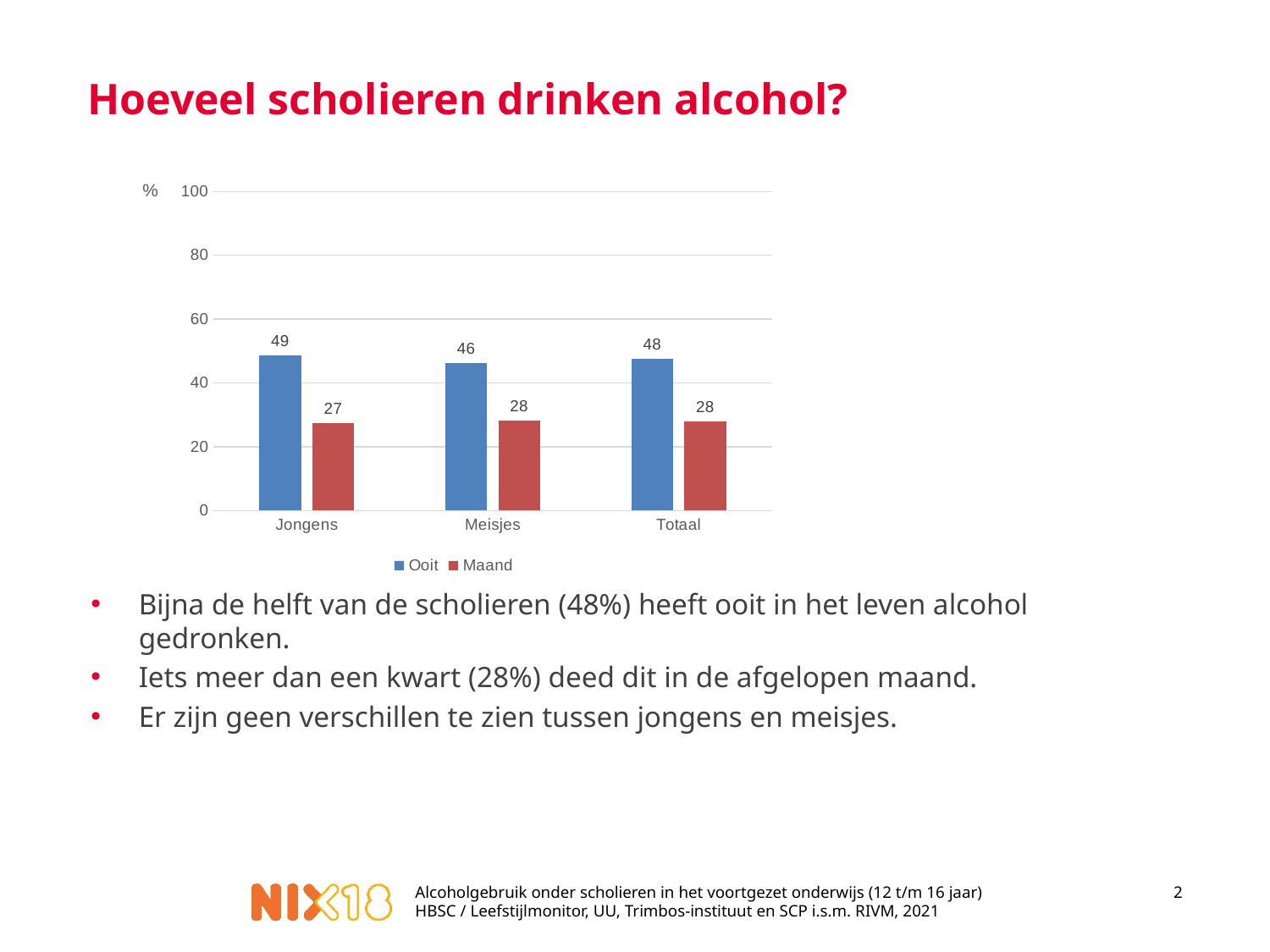
What is the difference between the Ooit and Maand values for Jongens? 22 How many categories are shown on the x axis? 3 What is the value for Maand for Meisjes? 28 Which category has the lowest Maand value? Jongens Is the Ooit value for Meisjes greater or less than 40? greater Which category has the highest Ooit value? Jongens What is the value for Ooit for Jongens? 49 Which is larger for Meisjes, the Ooit value or the Maand value? Ooit What is the value for Ooit for Totaal? 48 How many series does the legend list? 2 What kind of chart is shown on the slide? bar chart Which colour represents the Maand series? red